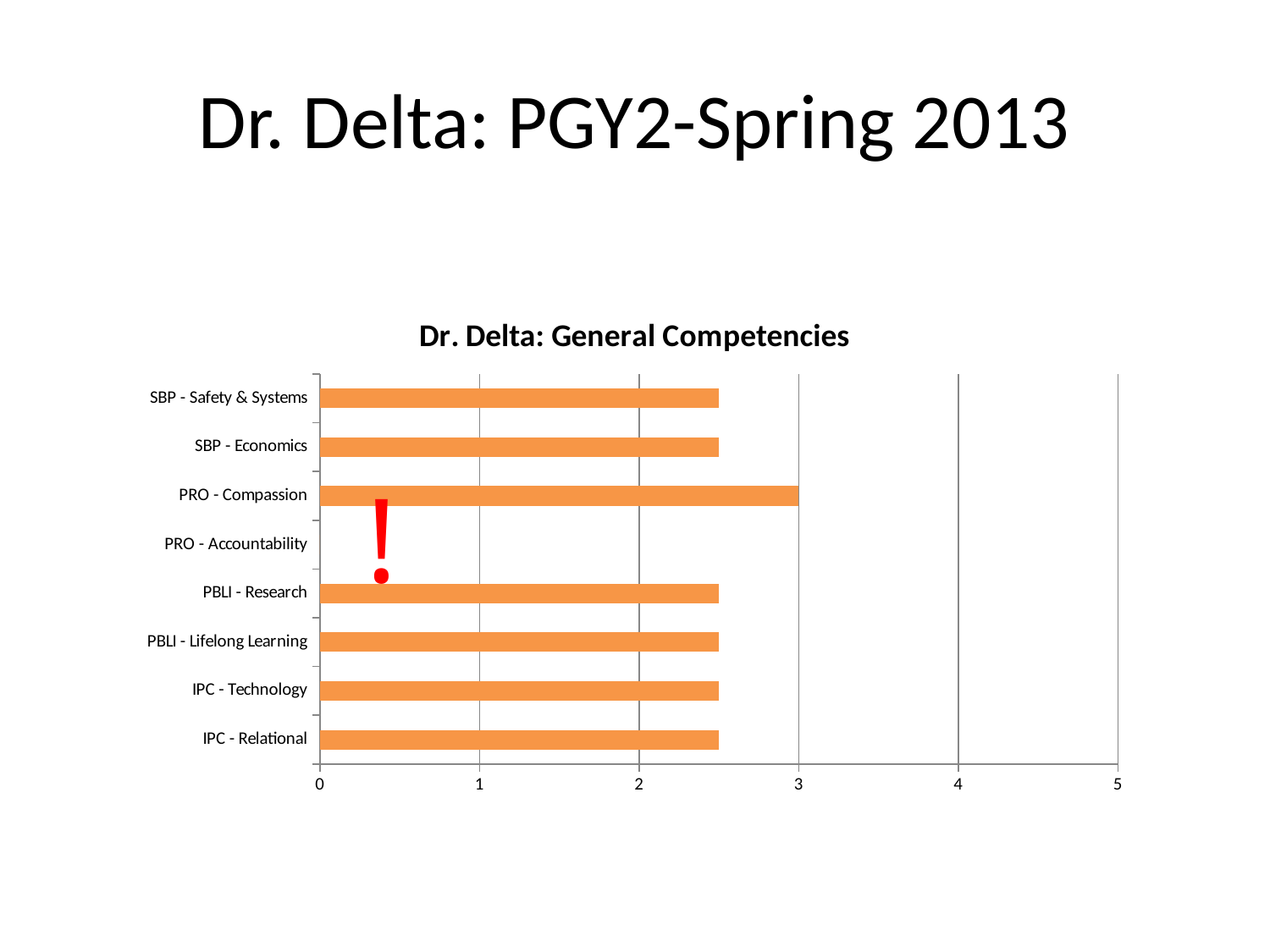
How many competency categories are listed on the chart? 8 What kind of chart is shown on the slide? bar chart Which is larger, the value for PRO - Compassion or the value for IPC - Technology? PRO - Compassion What is the value for PRO - Compassion? 3 Is the value for SBP - Economics greater or less than 2? greater Is the value for IPC - Relational greater or less than 3? less What is the maximum value shown on the horizontal axis? 5 Which category has the highest value? PRO - Compassion What is the title of the chart? Dr. Delta: General Competencies Which category has no visible bar (the lowest value)? PRO - Accountability Is the value for PBLI - Research greater or less than 4? less